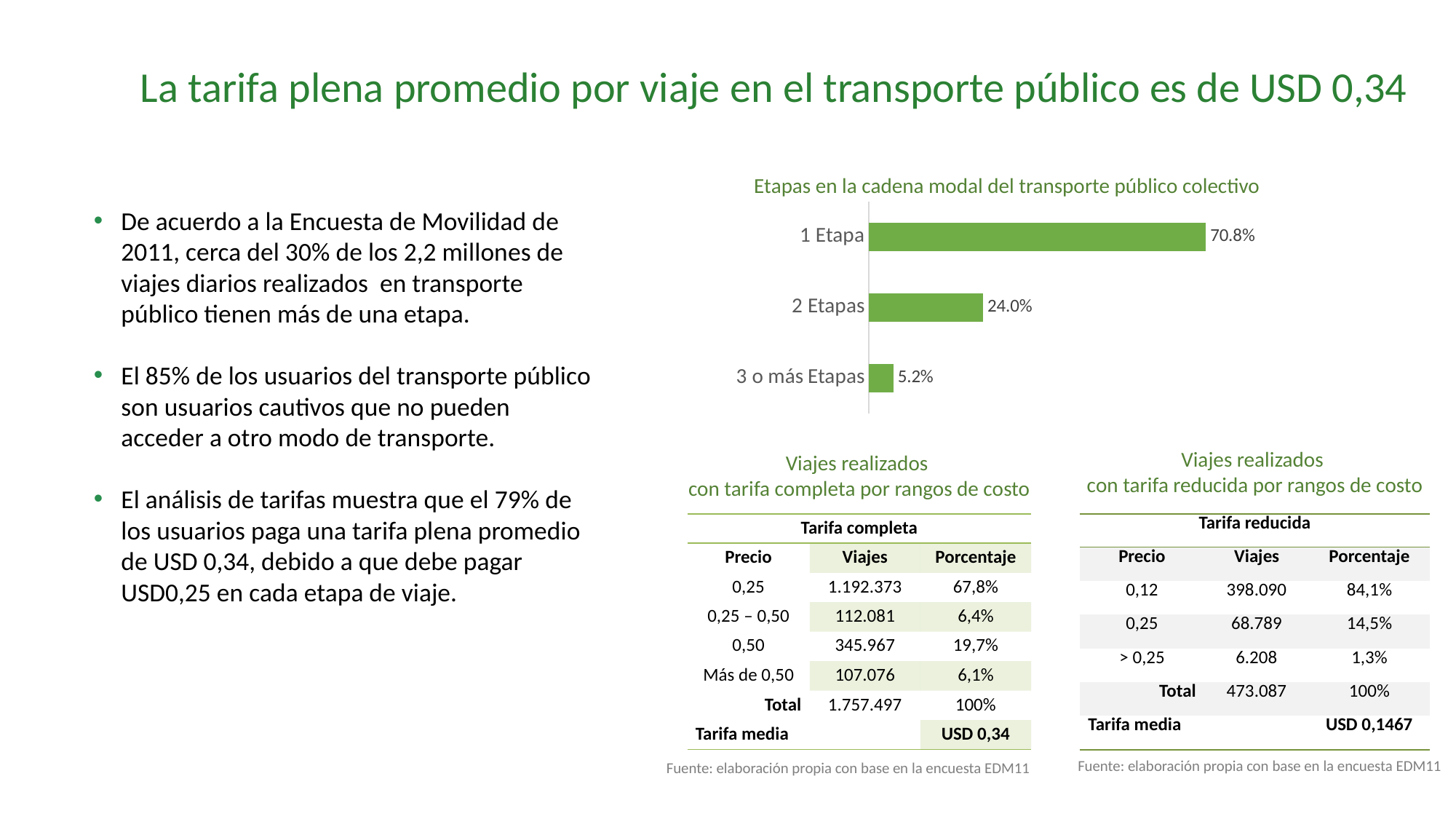
In the chart 'Etapas en la cadena modal del transporte público colectivo', what is the difference between the values for 2 Etapas and 3 o más Etapas? 18.8% In the chart 'Etapas en la cadena modal del transporte público colectivo', what is the difference between the values for 1 Etapa and 2 Etapas? 46.8% What is the value for 3 o más Etapas in the chart 'Etapas en la cadena modal del transporte público colectivo'? 5.2% What colour are the bars in the chart 'Etapas en la cadena modal del transporte público colectivo'? Green What is the title of the bar chart on the slide? Etapas en la cadena modal del transporte público colectivo Which category has the highest value in the chart 'Etapas en la cadena modal del transporte público colectivo'? 1 Etapa What kind of chart is 'Etapas en la cadena modal del transporte público colectivo'? Bar chart In the chart 'Etapas en la cadena modal del transporte público colectivo', which is larger: the value for 2 Etapas or the value for 3 o más Etapas? 2 Etapas How many categories are shown in the chart 'Etapas en la cadena modal del transporte público colectivo'? 3 What is the value for 1 Etapa in the chart 'Etapas en la cadena modal del transporte público colectivo'? 70.8% What is the value for 2 Etapas in the chart 'Etapas en la cadena modal del transporte público colectivo'? 24.0% Which category has the lowest value in the chart 'Etapas en la cadena modal del transporte público colectivo'? 3 o más Etapas